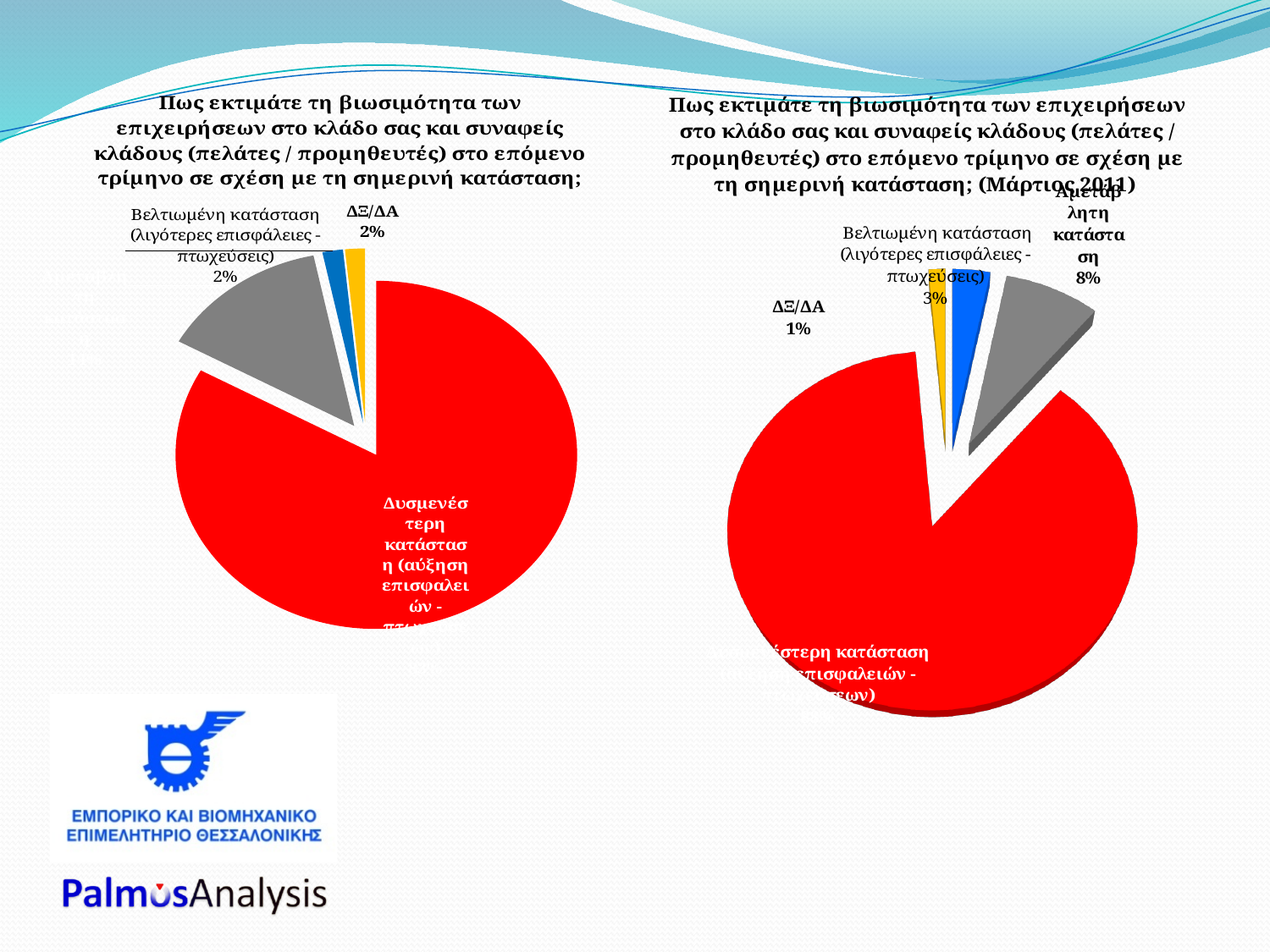
In the right chart (Μάρτιος 2011), what percentage is shown for 'Βελτιωμένη κατάσταση (λιγότερες επισφάλειες - πτωχεύσεις)'? 3% In the right chart (Μάρτιος 2011), what percentage is shown for 'ΔΞ/ΔΑ'? 1% In the left chart, what percentage is shown for 'Βελτιωμένη κατάσταση (λιγότερες επισφάλειες - πτωχεύσεις)'? 2% In the right chart (Μάρτιος 2011), which category has the smallest slice? ΔΞ/ΔΑ In the right chart (Μάρτιος 2011), what is the difference in percentage points between 'Αμετάβλητη κατάσταση' and 'Βελτιωμένη κατάσταση'? 5 percentage points In the left chart, what percentage is shown for 'ΔΞ/ΔΑ'? 2% What type of chart is the left chart on the slide? Pie chart How many slices does the right chart (Μάρτιος 2011) have? 4 In the right chart (Μάρτιος 2011), which is larger: 'Αμετάβλητη κατάσταση' or 'Βελτιωμένη κατάσταση'? Αμετάβλητη κατάσταση Which month and year is referenced in the title of the right chart? Μάρτιος 2011 In the right chart (Μάρτιος 2011), what percentage is shown for 'Αμετάβλητη κατάσταση'? 8% In the left chart, which category has the largest slice? Δυσμενέστερη κατάσταση (αύξηση επισφαλειών - πτωχεύσεων)